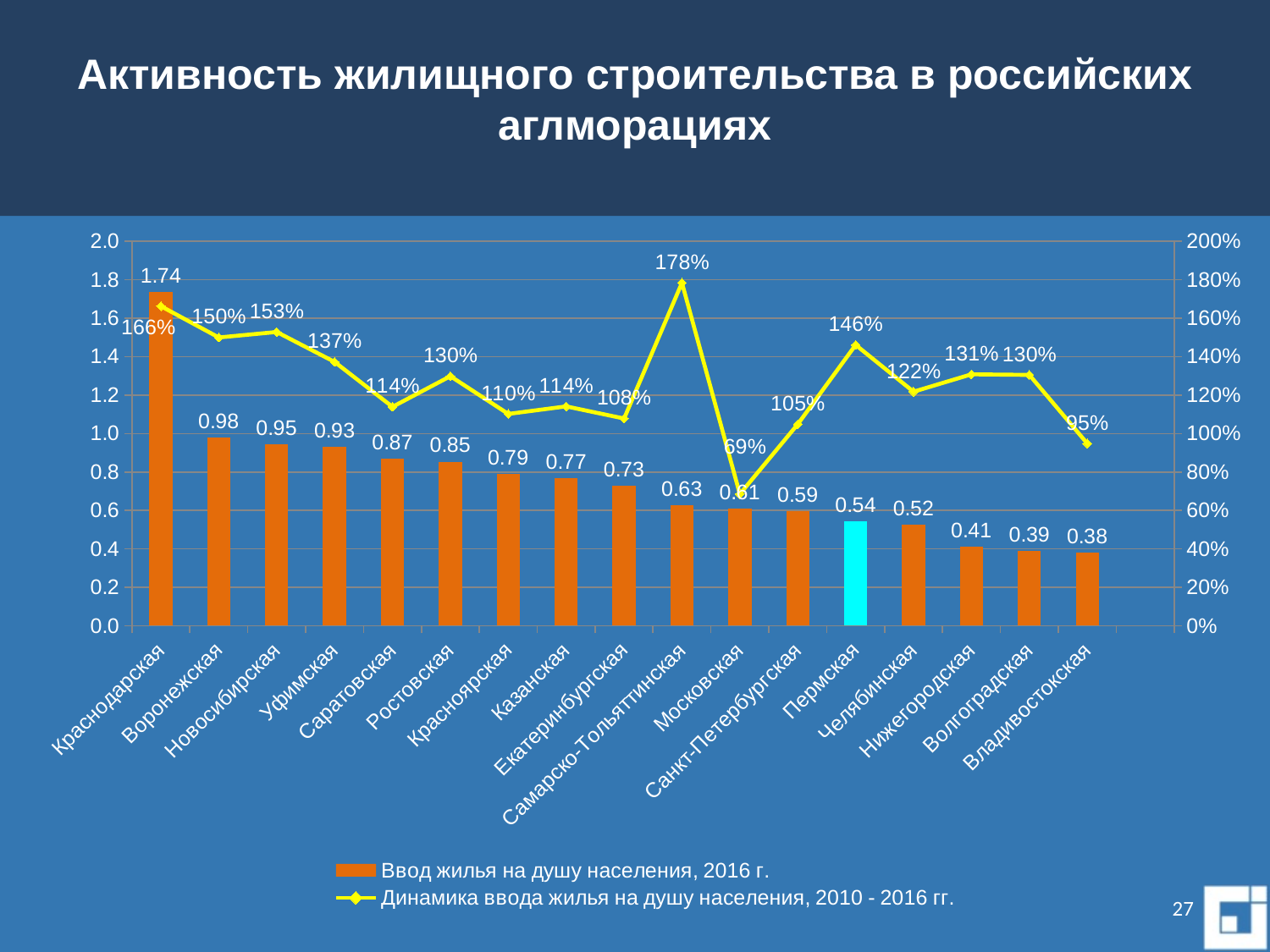
What is the value of 'Ввод жилья на душу населения, 2016 г.' for Воронежская? 0.98 What is the value of 'Динамика ввода жилья на душу населения, 2010 - 2016 гг.' for Нижегородская? 131% What kind of chart is shown on the slide? A bar chart combined with a line chart How many series does the legend list? 2 Which has a higher 'Ввод жилья на душу населения, 2016 г.' value, Пермская or Челябинская? Пермская Which agglomeration has the lowest value of 'Ввод жилья на душу населения, 2016 г.'? Владивостокская How many agglomerations are shown on the x axis? 17 What is the difference between the 'Ввод жилья на душу населения, 2016 г.' values for Краснодарская and Воронежская? 0.76 Which agglomeration has the lowest value on the 'Динамика ввода жилья на душу населения, 2010 - 2016 гг.' line? Московская Which agglomeration's bar is highlighted in a different colour (cyan) from the others? Пермская What is the value of 'Динамика ввода жилья на душу населения, 2010 - 2016 гг.' for Самарско-Тольяттинская? 178% Which agglomeration has the highest value of 'Ввод жилья на душу населения, 2016 г.'? Краснодарская